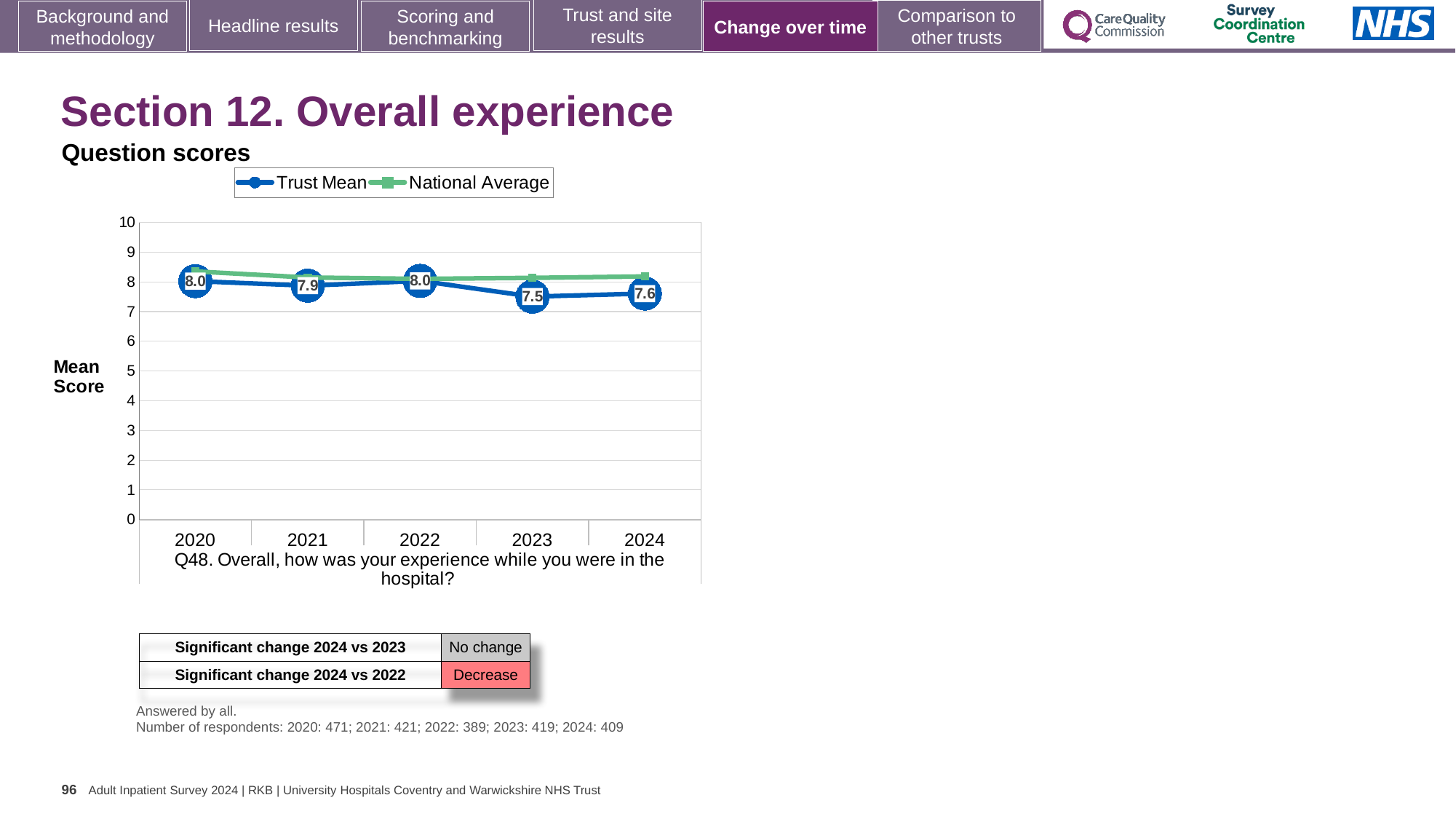
What is the Trust Mean score for 2020? 8.0 How many years are plotted on the x axis? 5 What kind of chart is shown on the slide? line chart What is the Trust Mean score for 2024? 7.6 How many series does the legend list? 2 What are the two series named in the chart legend? Trust Mean and National Average What is the Trust Mean score for 2023? 7.5 Which year has the larger Trust Mean score, 2023 or 2024? 2024 Is the National Average value for 2020 greater or less than 8? greater In which year is the Trust Mean score lowest? 2023 Does the Trust Mean score rise or fall overall from 2020 to 2024? fall What is the difference between the Trust Mean scores for 2022 and 2023? 0.5